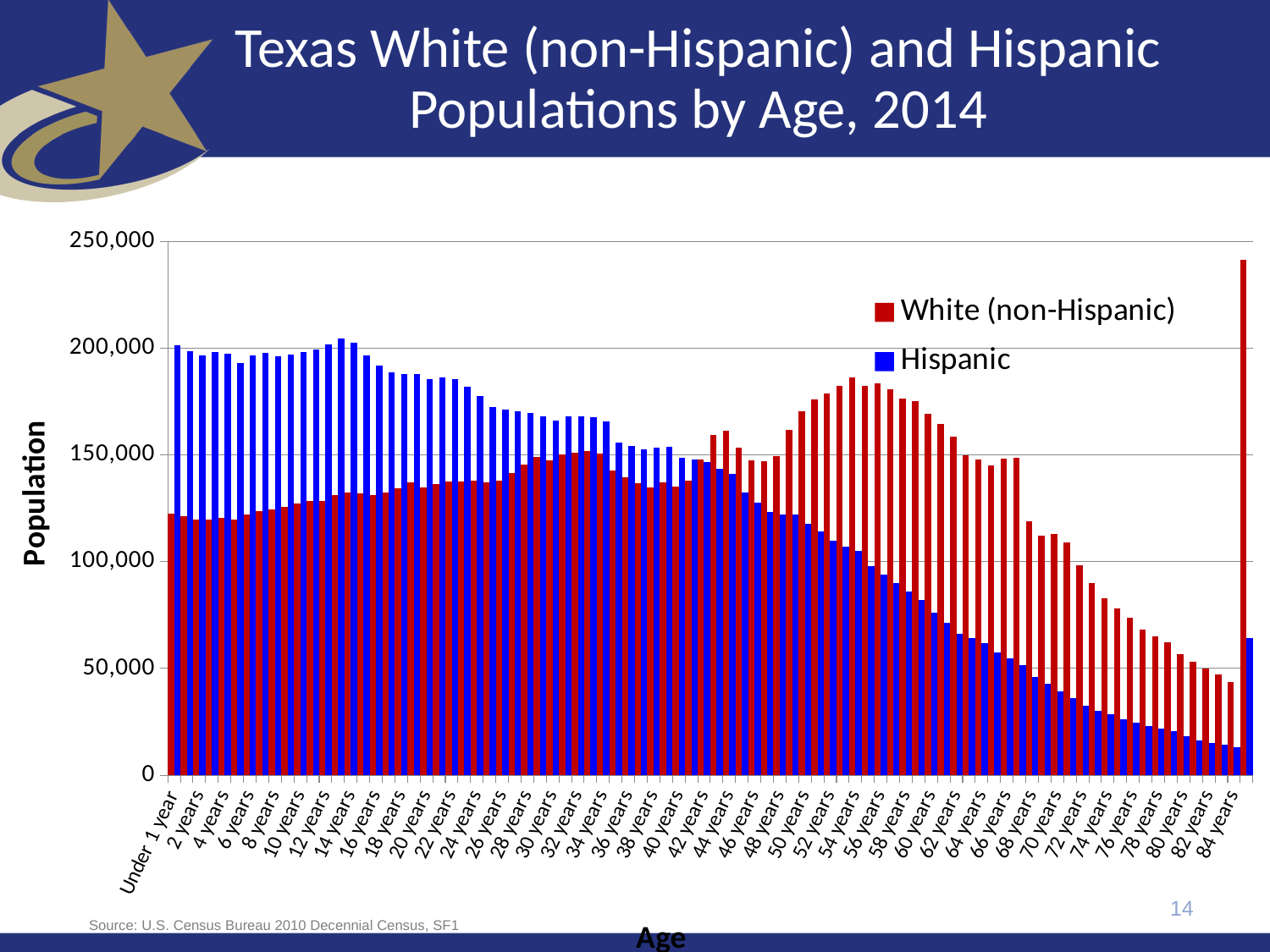
At 54 years, which series has the larger value, White (non-Hispanic) or Hispanic? White (non-Hispanic) Is the Hispanic value for 84 years greater or less than 50,000? less Is the Hispanic value for 60 years greater or less than 100,000? less Do the Hispanic values generally rise or fall as age increases from 14 years to 84 years? fall How many series does the legend list? 2 Is the White (non-Hispanic) value for 54 years greater or less than 200,000? less What is the label on the vertical axis of the chart? Population What kind of chart is shown on the slide? bar chart At 2 years, which series has the larger value, White (non-Hispanic) or Hispanic? Hispanic Which two series are listed in the chart legend? White (non-Hispanic) and Hispanic